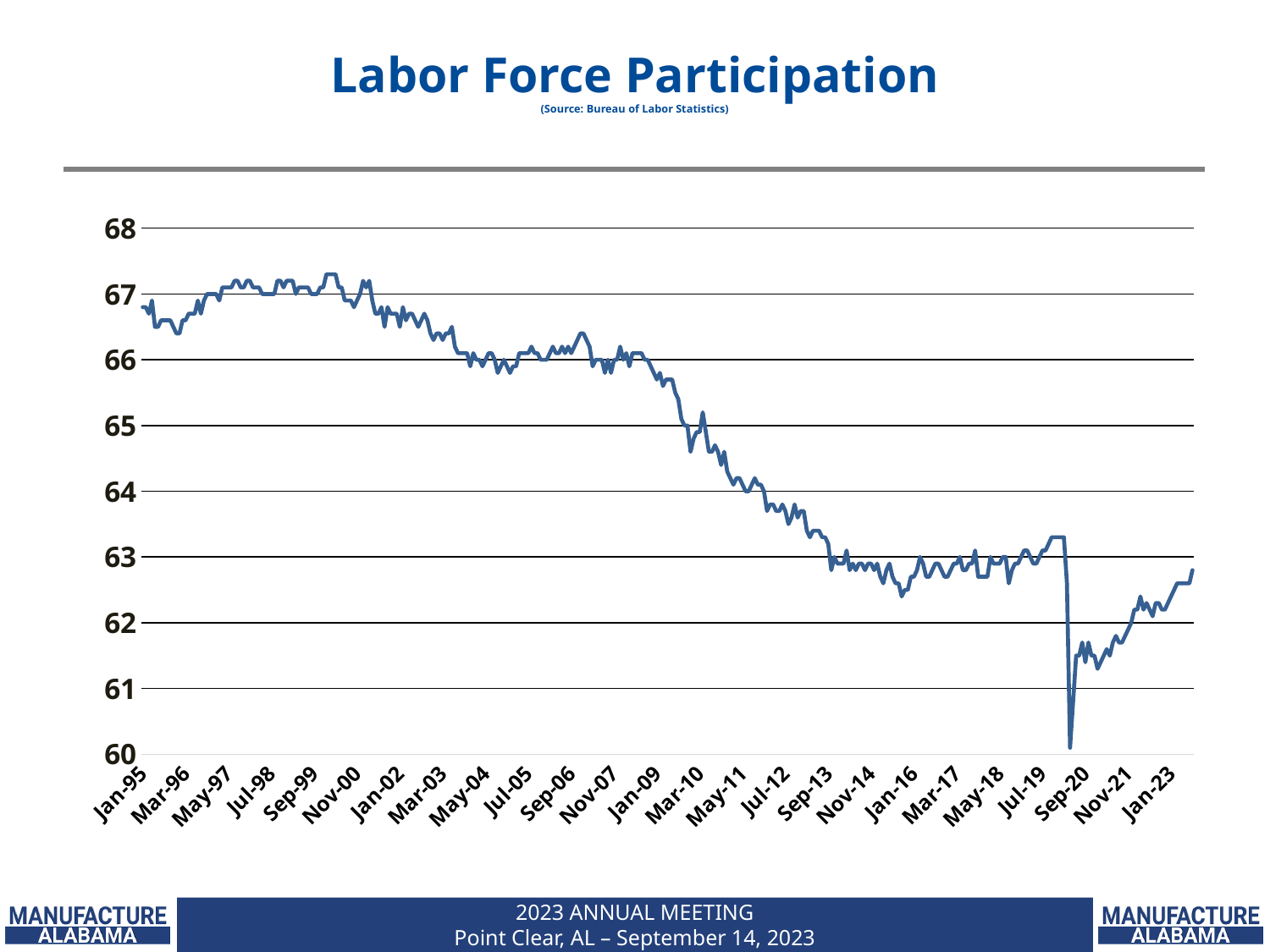
Is the value at Jan-09 greater or less than 65? greater What kind of chart is shown on the slide? line chart Is the value at Jan-95 greater or less than 66? greater What is the title of the chart? Labor Force Participation Does the line rise or fall between Sep-20 and Jan-23? rise Overall, does the line rise or fall from Jan-95 to Jan-23? fall Is the value at Sep-13 greater or less than 64? less Near which x-axis label does the line reach its lowest point? Sep-20 What source is cited for the chart? Bureau of Labor Statistics How many date labels are shown on the x axis? 25